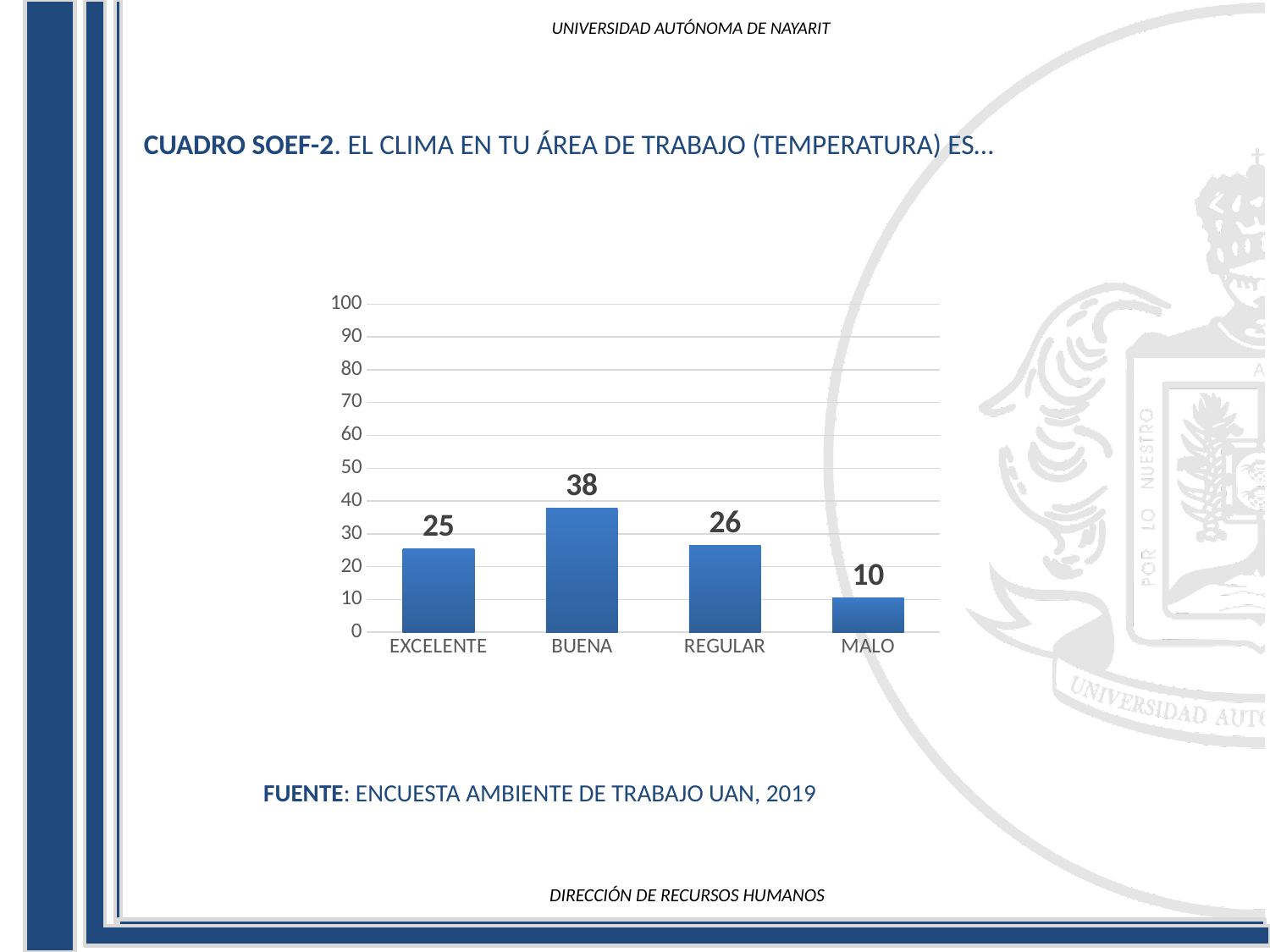
What is the difference between the values for REGULAR and EXCELENTE? 1 Which is larger, the value for BUENA or the value for REGULAR? BUENA Is the value for BUENA greater or less than 50? less How many categories are shown on the x axis? 4 What is the value for BUENA? 38 What is the difference between the values for BUENA and MALO? 28 Which category has the lowest value? MALO What kind of chart is shown on the slide? bar chart What is the value for MALO? 10 What is the value for EXCELENTE? 25 What is the value for REGULAR? 26 Which category has the highest value? BUENA